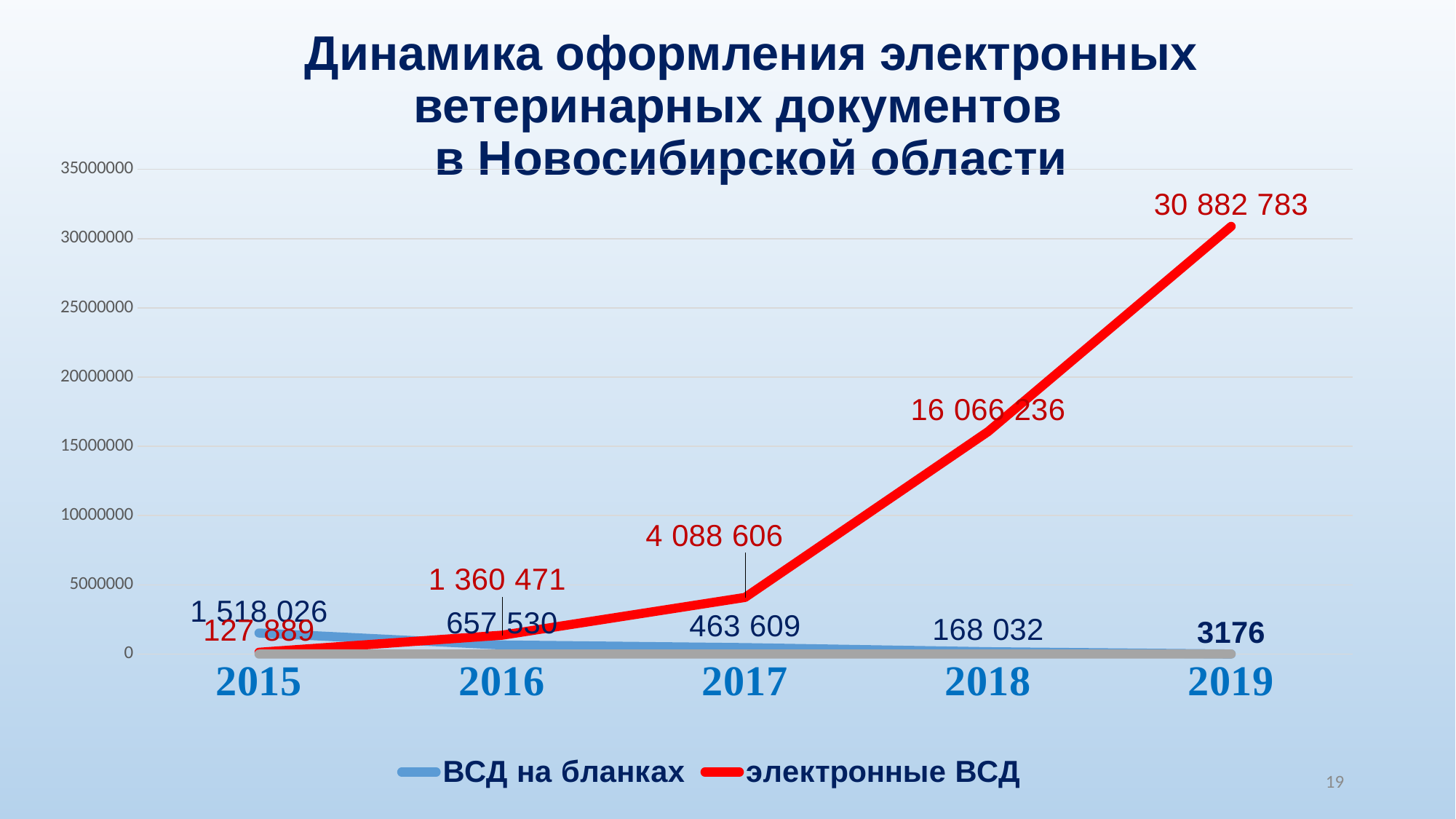
In which year is the value of электронные ВСД the highest? 2019 Does the value of ВСД на бланках rise or fall from 2015 to 2019? fall What is the value of электронные ВСД in 2017? 4 088 606 In which year is the value of ВСД на бланках the lowest? 2019 What is the difference between the электронные ВСД values for 2019 and 2018? 14 816 547 How many years are shown on the x axis? 5 How many series does the legend list? 2 What is the value of ВСД на бланках in 2015? 1 518 026 What is the value of ВСД на бланках in 2019? 3176 In 2016, which series has the larger value: ВСД на бланках or электронные ВСД? электронные ВСД What kind of chart is shown on the slide? line chart What is the value of электронные ВСД in 2019? 30 882 783